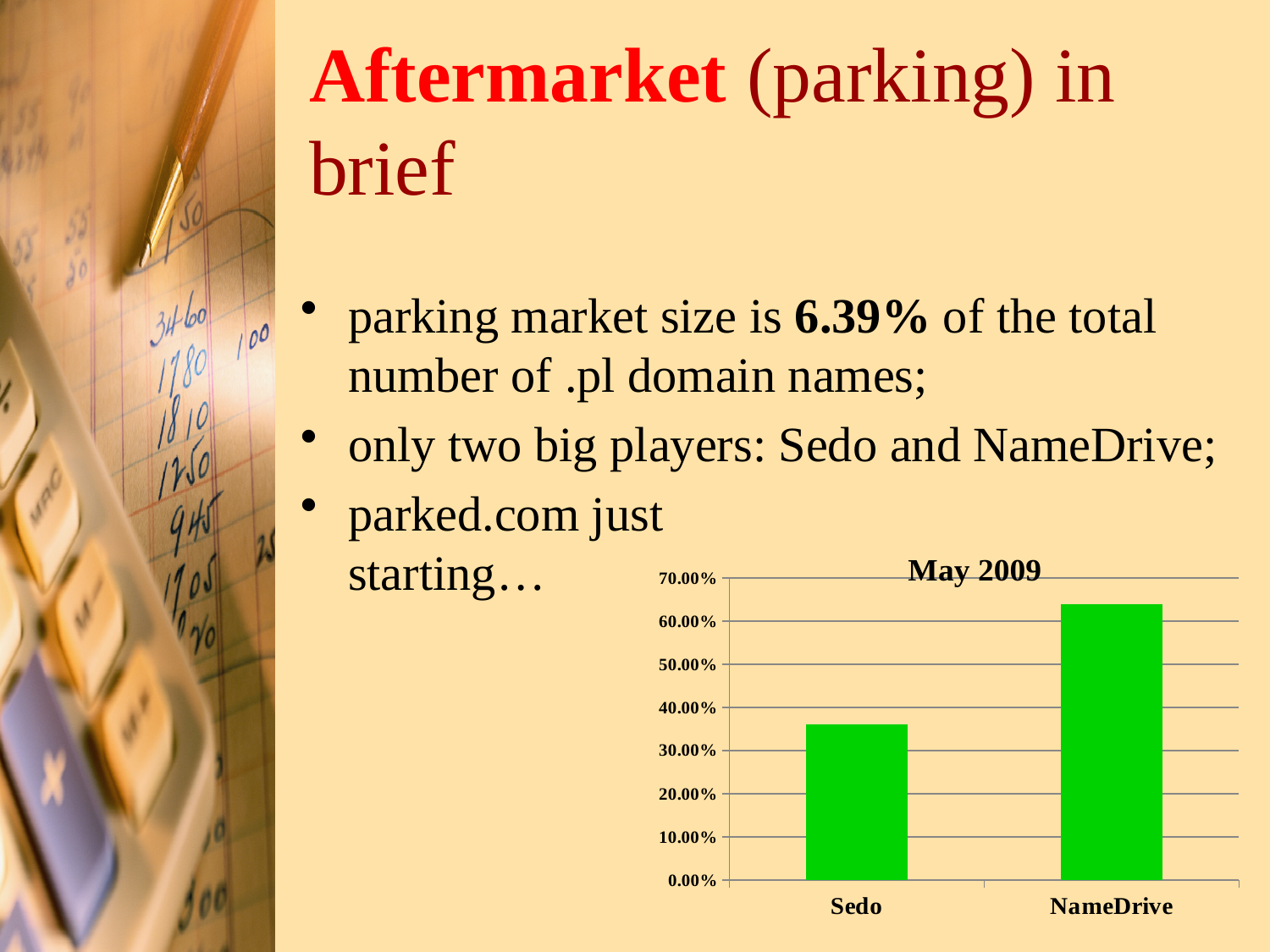
Which category has the lowest value in the chart? Sedo What type of chart is shown on the slide? bar chart Is the value for Sedo greater or less than 30.00%? greater Is the value for NameDrive greater or less than 60.00%? greater How many categories are shown on the chart's x axis? 2 Which is larger, the value for Sedo or the value for NameDrive? NameDrive Which category has the highest value in the chart? NameDrive What is the title of the chart? May 2009 What is the highest value labelled on the chart's vertical axis? 70.00% Is the value for NameDrive greater or less than 70.00%? less